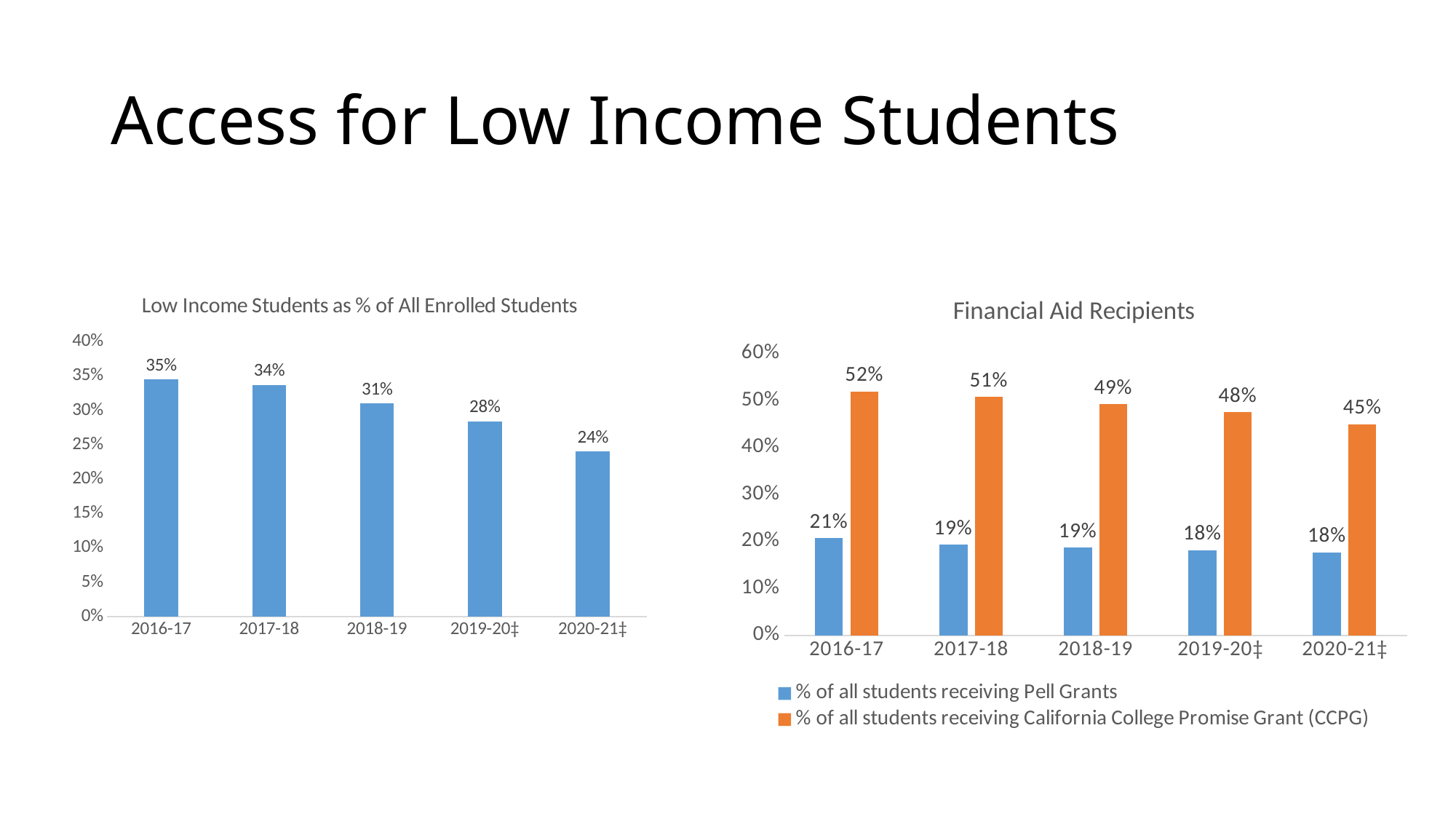
In the 'Financial Aid Recipients' chart, what percentage of all students received Pell Grants in 2016-17? 21% How many series does the legend of the 'Financial Aid Recipients' chart list? 2 In the 'Financial Aid Recipients' chart, what percentage of all students received the California College Promise Grant (CCPG) in 2019-20‡? 48% In the 'Financial Aid Recipients' chart, which is larger in 2017-18: the Pell Grants value or the CCPG value? CCPG In the 'Financial Aid Recipients' chart, which year has the highest CCPG value? 2016-17 In the 'Low Income Students as % of All Enrolled Students' chart, what is the value for 2018-19? 31% In the 'Financial Aid Recipients' chart, what is the difference between the CCPG and Pell Grant values in 2020-21‡? 27 percentage points In the 'Low Income Students as % of All Enrolled Students' chart, which year has the lowest value? 2020-21‡ In the 'Low Income Students as % of All Enrolled Students' chart, what is the difference between the 2016-17 and 2020-21‡ values? 11 percentage points How many years are shown in the 'Low Income Students as % of All Enrolled Students' chart? 5 What type of chart is the 'Financial Aid Recipients' chart? bar chart In the 'Low Income Students as % of All Enrolled Students' chart, do the values rise or fall from 2016-17 to 2020-21‡? fall